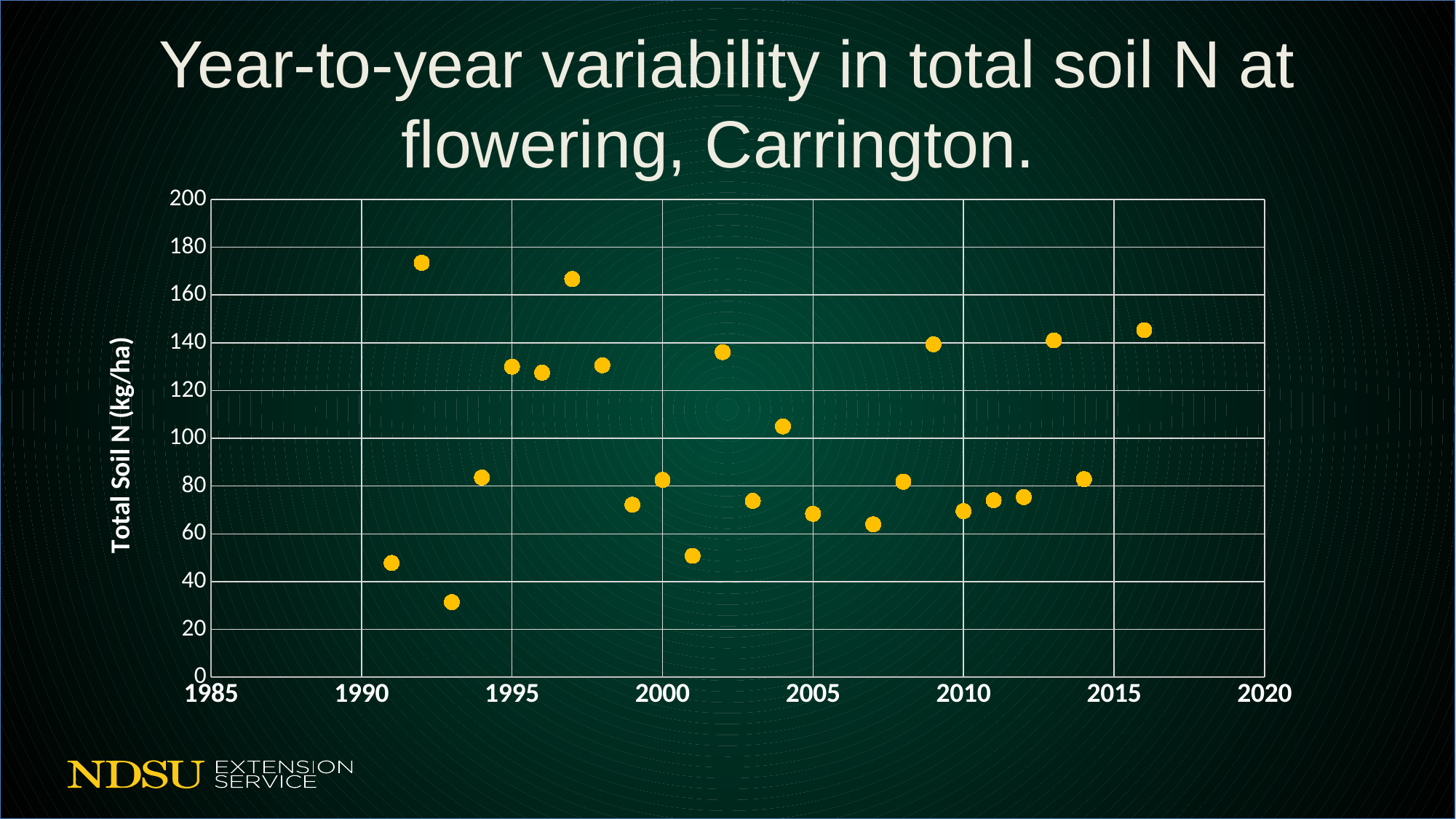
Is the value for 1993 greater or less than 40? less Is the value for 1992 greater or less than 160? greater In which year is the total soil N at flowering lowest? 1993 How many data points are plotted on the chart? 24 What is the label on the vertical axis of the chart? Total Soil N (kg/ha) Is the value for 2004 greater or less than 100? greater What is the title of the chart? Year-to-year variability in total soil N at flowering, Carrington. Which year has the larger total soil N value, 2002 or 2004? 2002 In which year is the total soil N at flowering highest? 1992 What kind of chart is shown on the slide? scatter chart